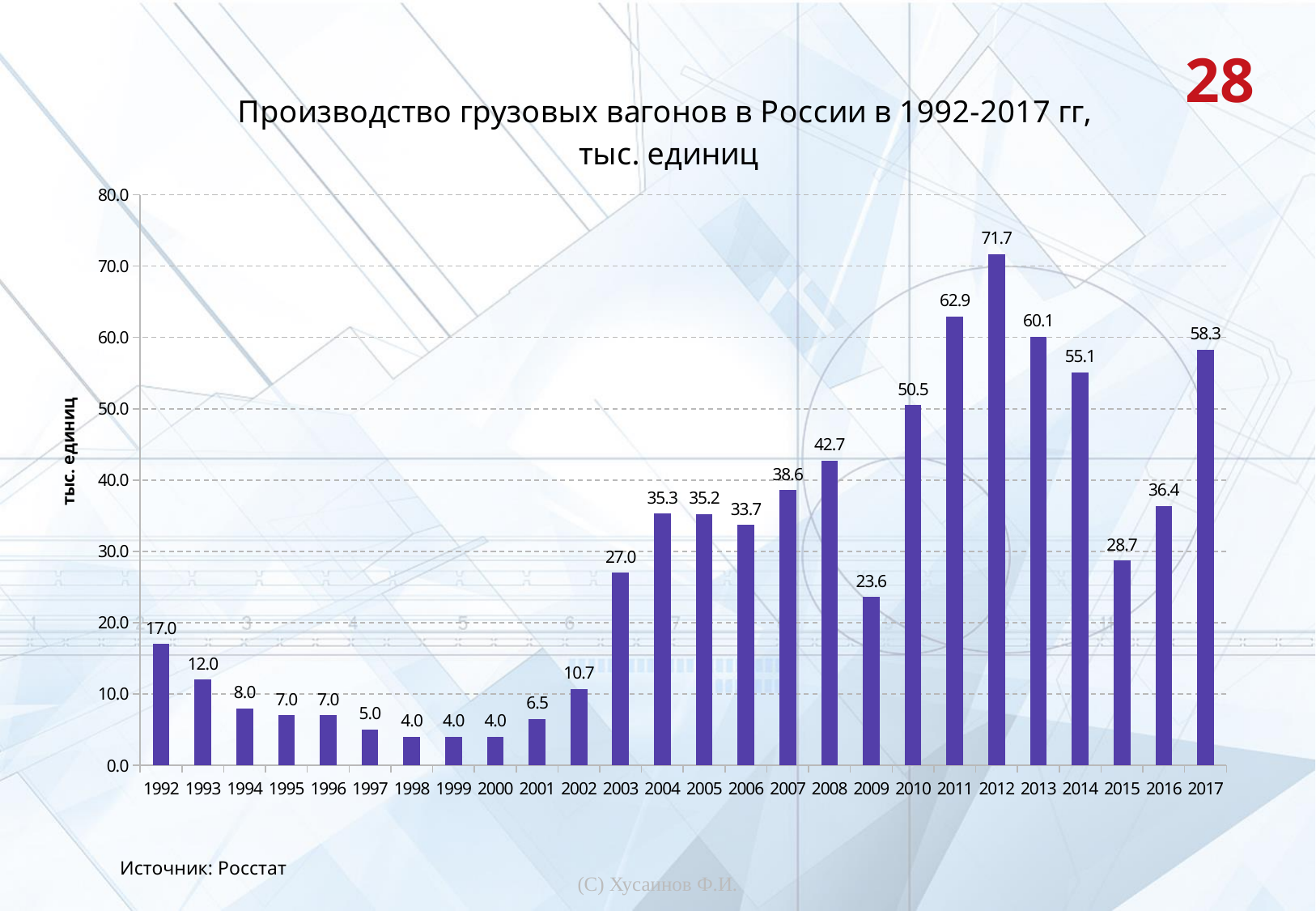
What is the difference between the values for 2012 and 2011? 8.8 How many years are shown on the x axis? 26 Do the values rise or fall from 1992 to 2000? fall What is the value for 2012? 71.7 Which is larger, the value for 2013 or the value for 2017? 2013 What kind of chart is this? bar chart What is the value for 2009? 23.6 What is the value for 1992? 17.0 Which year has the highest value? 2012 What is the title of the chart? Производство грузовых вагонов в России в 1992-2017 гг, тыс. единиц What is the source cited below the chart? Росстат Is the value for 2010 greater or less than 40.0? greater